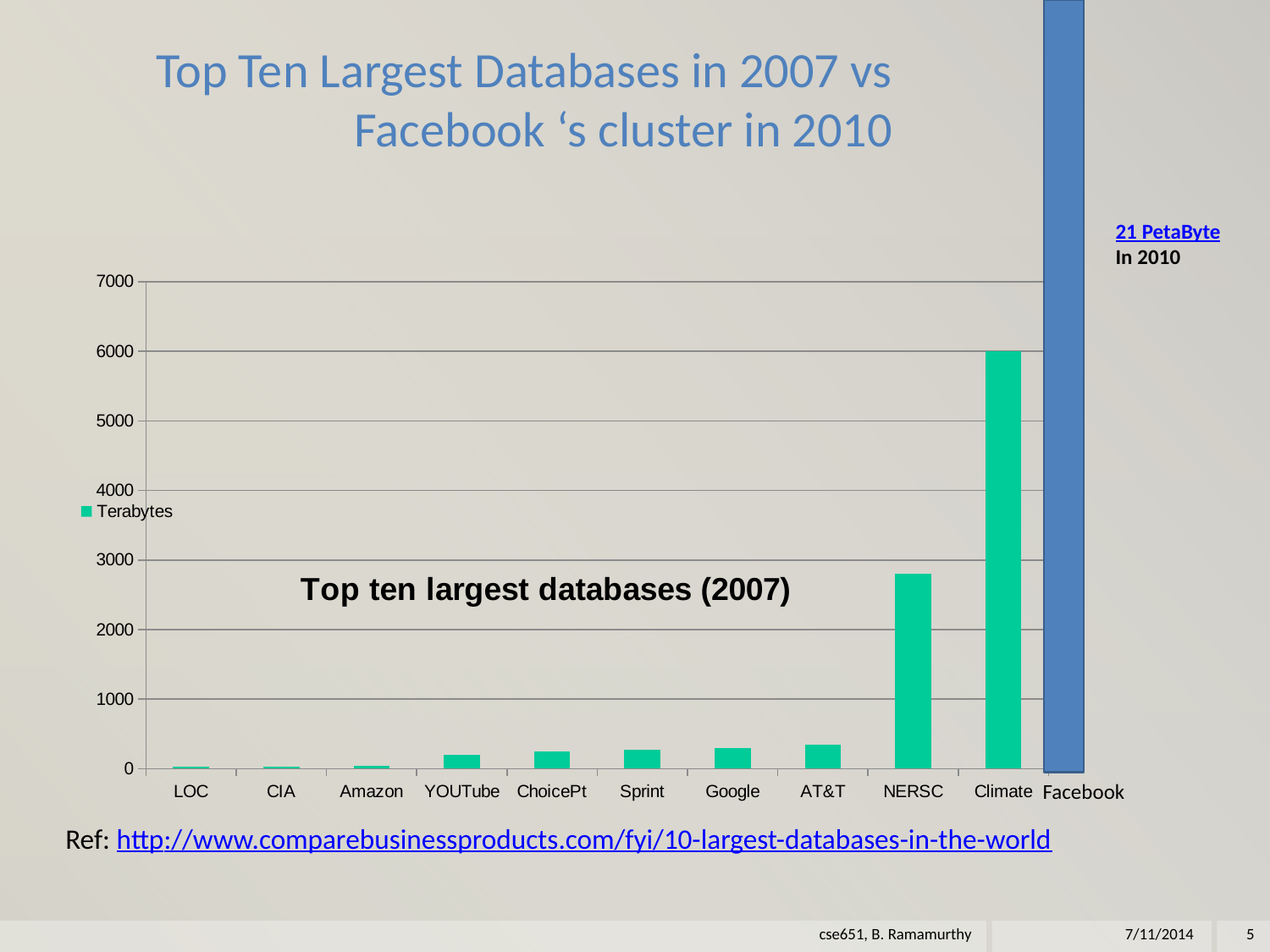
How many series does the chart's legend list? 1 Is the value for Google greater or less than 1000? less What is the title printed inside the chart area? Top ten largest databases (2007) Is the value for Climate greater or less than 5000? greater Which has the larger value, Sprint or NERSC? NERSC Among the 2007 databases plotted, which has the highest value? Climate Do the values of the 2007 databases generally rise or fall from left to right along the x axis? rise Which has the larger value, NERSC or Climate? Climate How many 2007 databases are plotted as bars on the chart's x axis, not counting the separate Facebook bar? 10 Is the value for NERSC greater or less than 2000? greater What kind of chart is shown on the slide? bar chart What is the single entry listed in the chart's legend? Terabytes